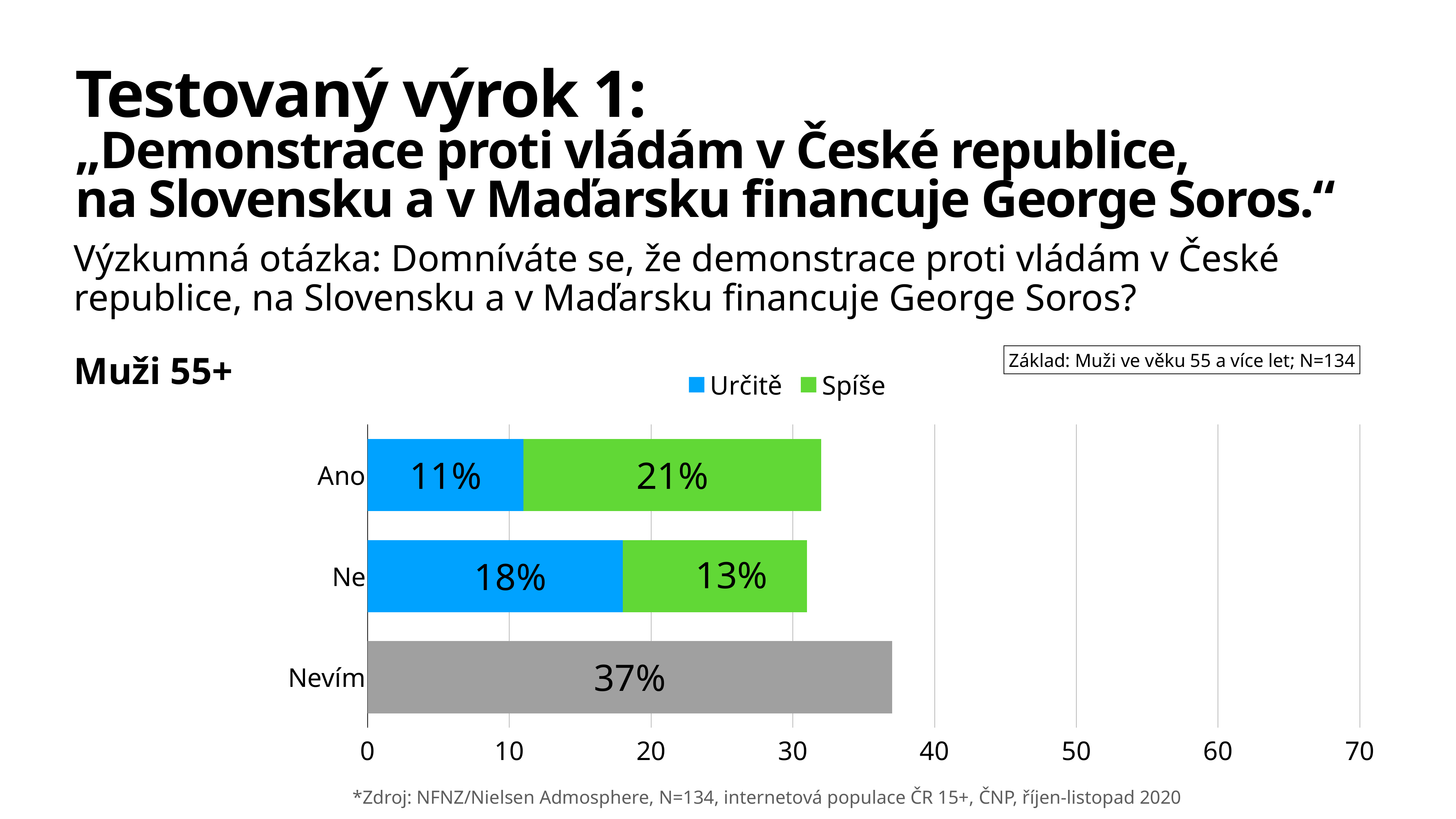
What is the 'Spíše' value for the 'Ano' category? 21% How many series does the legend list? 2 How many categories are shown on the chart? 3 What kind of chart is shown on the slide? Stacked bar chart What is the value shown for the 'Nevím' category? 37% Which is larger: the 'Spíše' value for 'Ano' or the 'Spíše' value for 'Ne'? Ano What is the total of the stacked bar for 'Ano'? 32% What is the 'Určitě' value for the 'Ano' category? 11% What is the total of the stacked bar for 'Ne'? 31% What is the 'Spíše' value for the 'Ne' category? 13% What is the difference between the 'Určitě' values for 'Ne' and 'Ano'? 7% Which category has the longest bar overall? Nevím